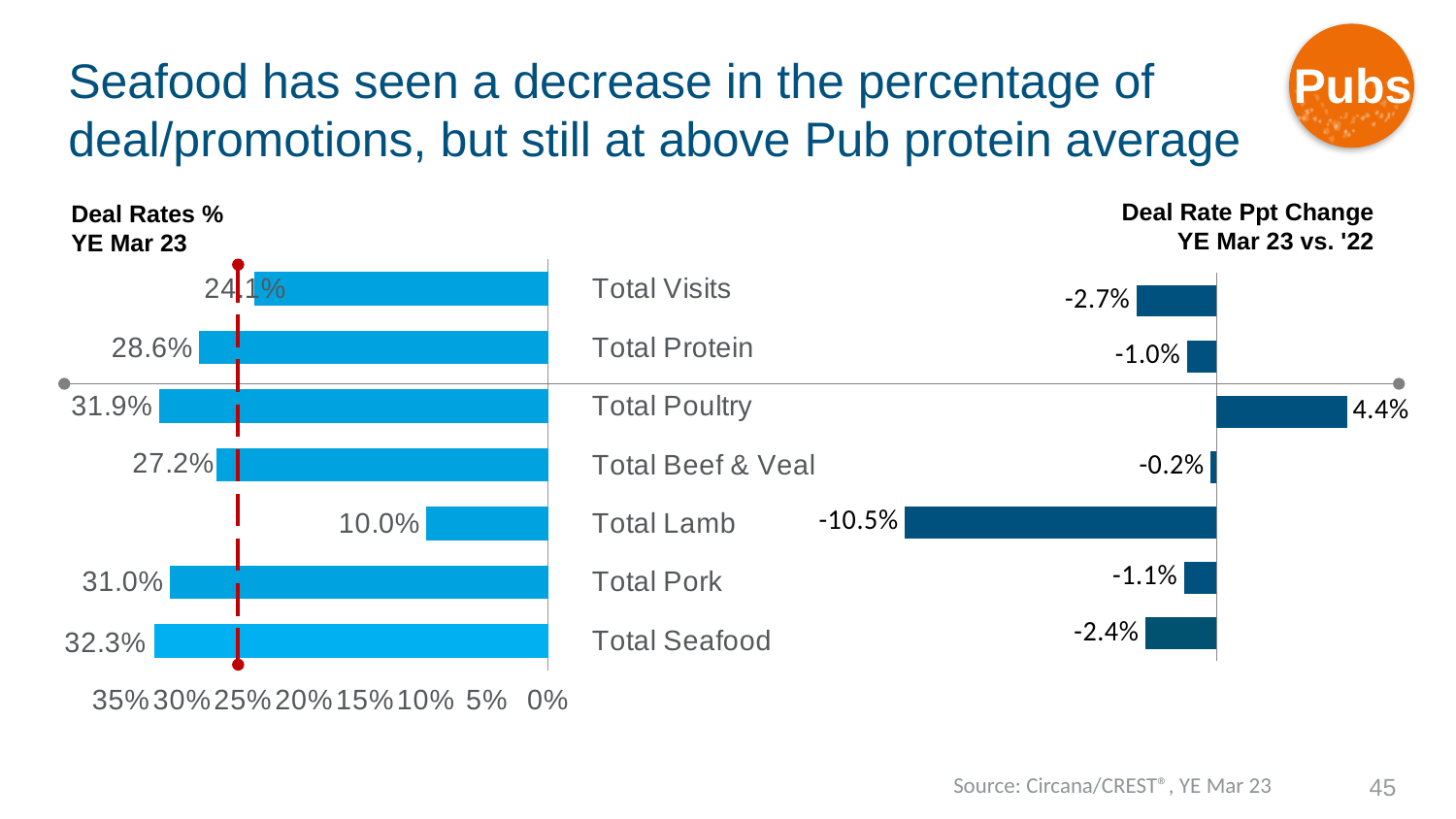
In the Deal Rates % YE Mar 23 chart, what is the difference between Total Seafood and Total Protein? 3.7 percentage points How many categories are shown in the Deal Rates % YE Mar 23 chart? 7 In the Deal Rates % YE Mar 23 chart, which category has the highest deal rate? Total Seafood In the Deal Rates % YE Mar 23 chart, what is the value for Total Seafood? 32.3% In the Deal Rate Ppt Change YE Mar 23 vs. '22 chart, what is the value for Total Seafood? -2.4% In the Deal Rates % YE Mar 23 chart, which is larger, Total Poultry or Total Pork? Total Poultry In the Deal Rates % YE Mar 23 chart, what is the value for Total Lamb? 10.0% In the Deal Rate Ppt Change YE Mar 23 vs. '22 chart, what is the value for Total Poultry? 4.4% In the Deal Rate Ppt Change YE Mar 23 vs. '22 chart, which category has the lowest value? Total Lamb What kind of chart is the Deal Rate Ppt Change YE Mar 23 vs. '22 chart? Bar chart In the Deal Rates % YE Mar 23 chart, which category has the lowest deal rate? Total Lamb In the Deal Rate Ppt Change YE Mar 23 vs. '22 chart, which category is the only one with a positive change? Total Poultry